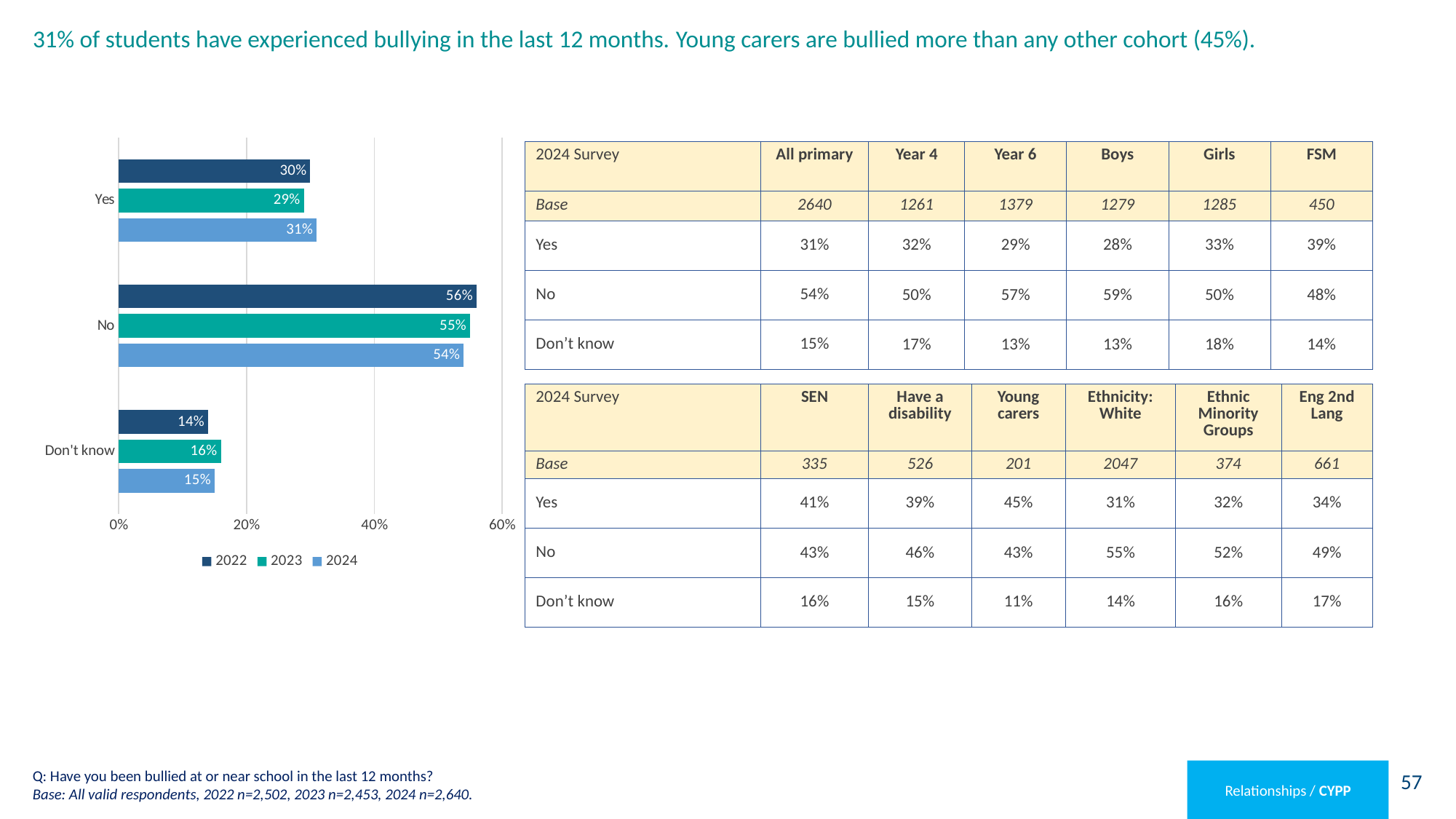
What is the difference between the 2022 and 2024 values for 'No' in the bar chart? 2% Which category has the highest value for 2024 in the bar chart? No How many categories are shown on the bar chart's vertical axis? 3 Which category has the lowest value for 2022 in the bar chart? Don't know What is the 2023 value for 'Don't know' in the bar chart? 16% In the bar chart, is the 2023 value for 'Yes' larger or the 2024 value for 'Yes'? 2024 What are the series names listed in the bar chart's legend? 2022, 2023, 2024 What type of chart is shown on the slide? Bar chart What is the 2024 value for 'Yes' in the bar chart? 31% What is the 2022 value for 'No' in the bar chart? 56% How many series does the bar chart's legend list? 3 What is the maximum value shown on the bar chart's horizontal axis? 60%